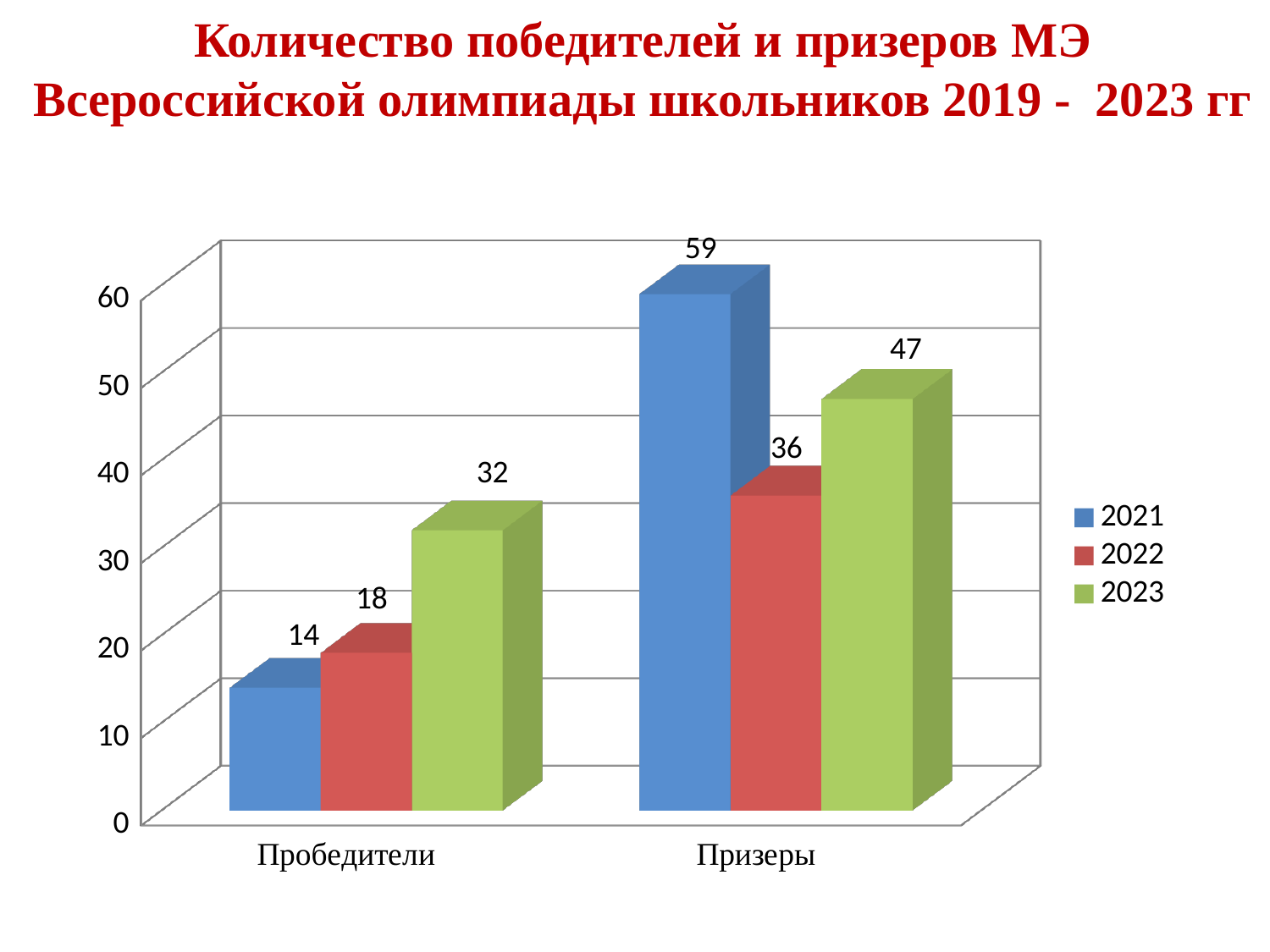
Which year has the highest value in the Призеры category? 2021 Which year has the lowest value in the Пробедители category? 2021 How many series does the legend list? 3 What is the value for 2021 in the Пробедители category? 14 What is the value for 2022 in the Пробедители category? 18 Which is larger: the 2022 value for Призеры or the 2023 value for Пробедители? 2022 value for Призеры What is the difference between the 2021 and 2022 values in the Призеры category? 23 Which colour represents the 2023 series in the legend? Green What is the difference between the 2023 and 2021 values in the Пробедители category? 18 How many categories are shown on the x axis? 2 What kind of chart is shown on the slide? Bar chart What is the value for 2023 in the Призеры category? 47